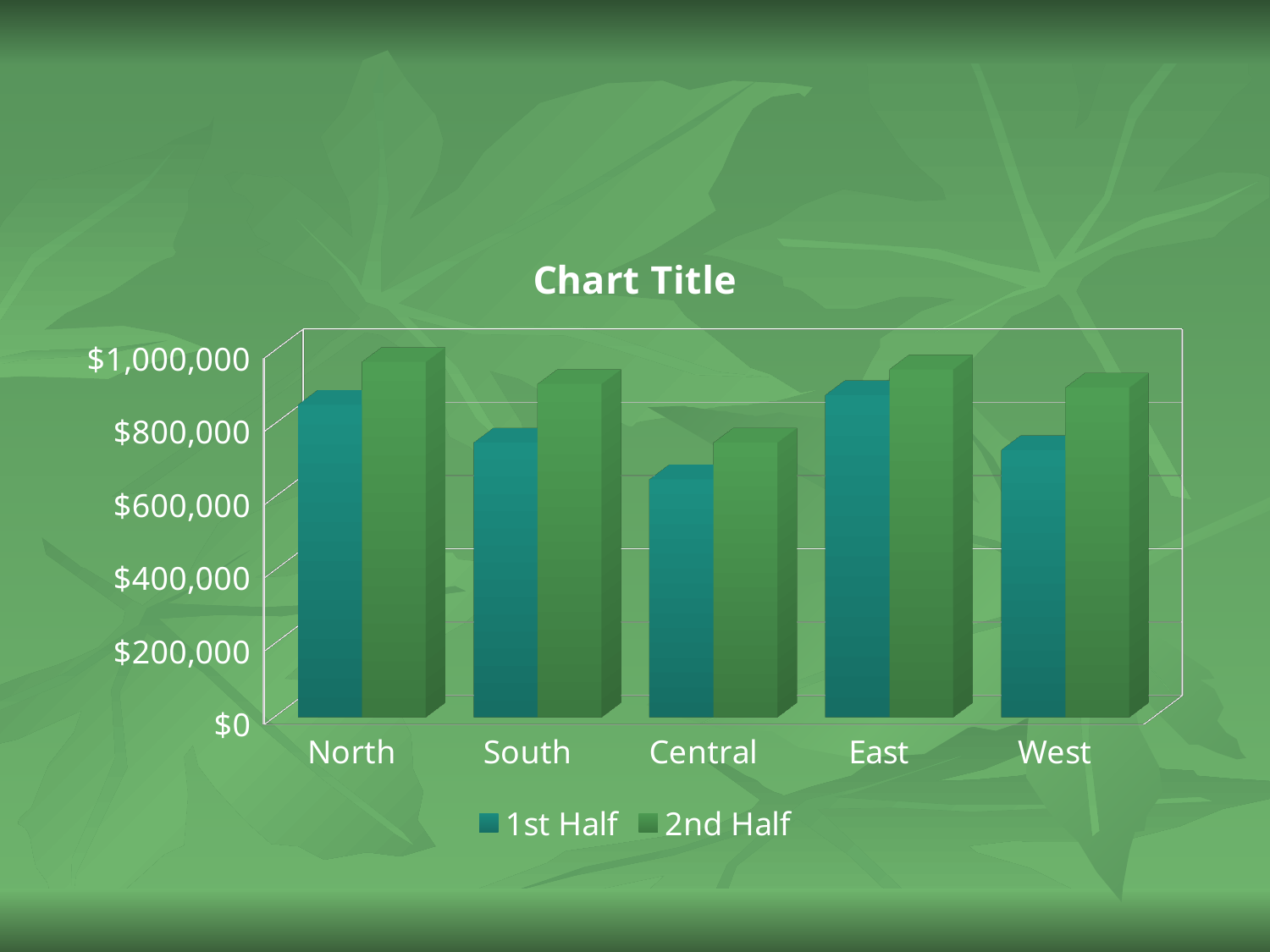
How many series does the chart's legend list? 2 For West, which is larger: the 1st Half value or the 2nd Half value? 2nd Half Which category has the lowest 2nd Half value? Central Is the 1st Half value for Central greater or less than $800,000? less What is the title of the chart? Chart Title Which category has the lowest 1st Half value? Central For Central, which is larger: the 1st Half value or the 2nd Half value? 2nd Half How many categories are shown on the x axis of the chart? 5 Is the 1st Half value for Central greater or less than $600,000? greater What are the two series named in the chart's legend? 1st Half and 2nd Half What kind of chart is shown on the slide? Bar chart Is the 2nd Half value for North greater or less than $800,000? greater